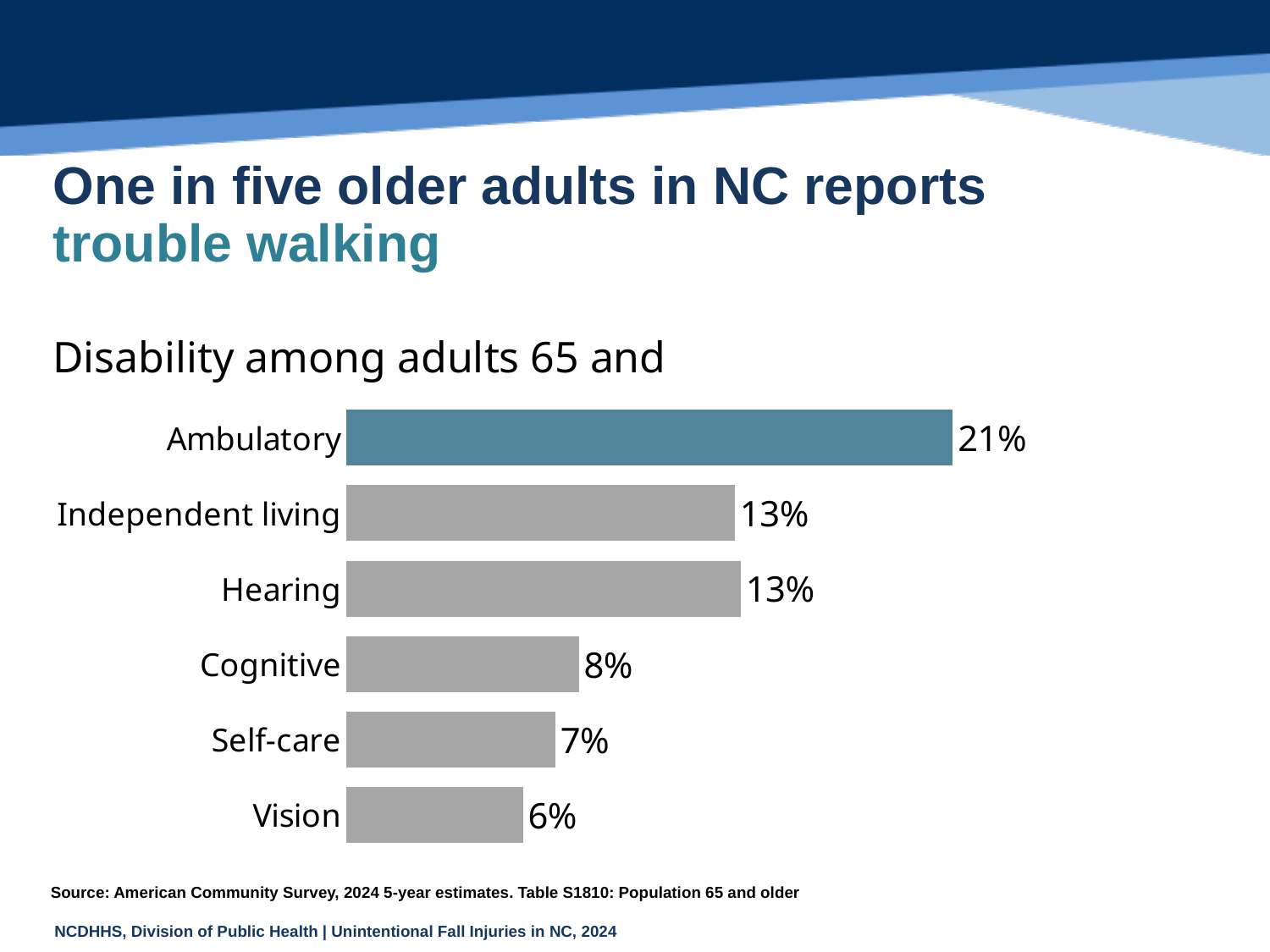
What is the value for Vision disability? 6% Which bar is shown in a different colour from the others? Ambulatory What kind of chart is shown on the slide? Bar chart What is the difference between the Cognitive and Vision values? 2% What is the value for Self-care disability? 7% What is the value for Ambulatory disability? 21% What is the difference between the Ambulatory and Independent living values? 8% What is the value for Cognitive disability? 8% Which disability category has the highest value? Ambulatory Which is larger, the value for Hearing or the value for Cognitive? Hearing How many disability categories are shown in the chart? 6 Which disability category has the lowest value? Vision